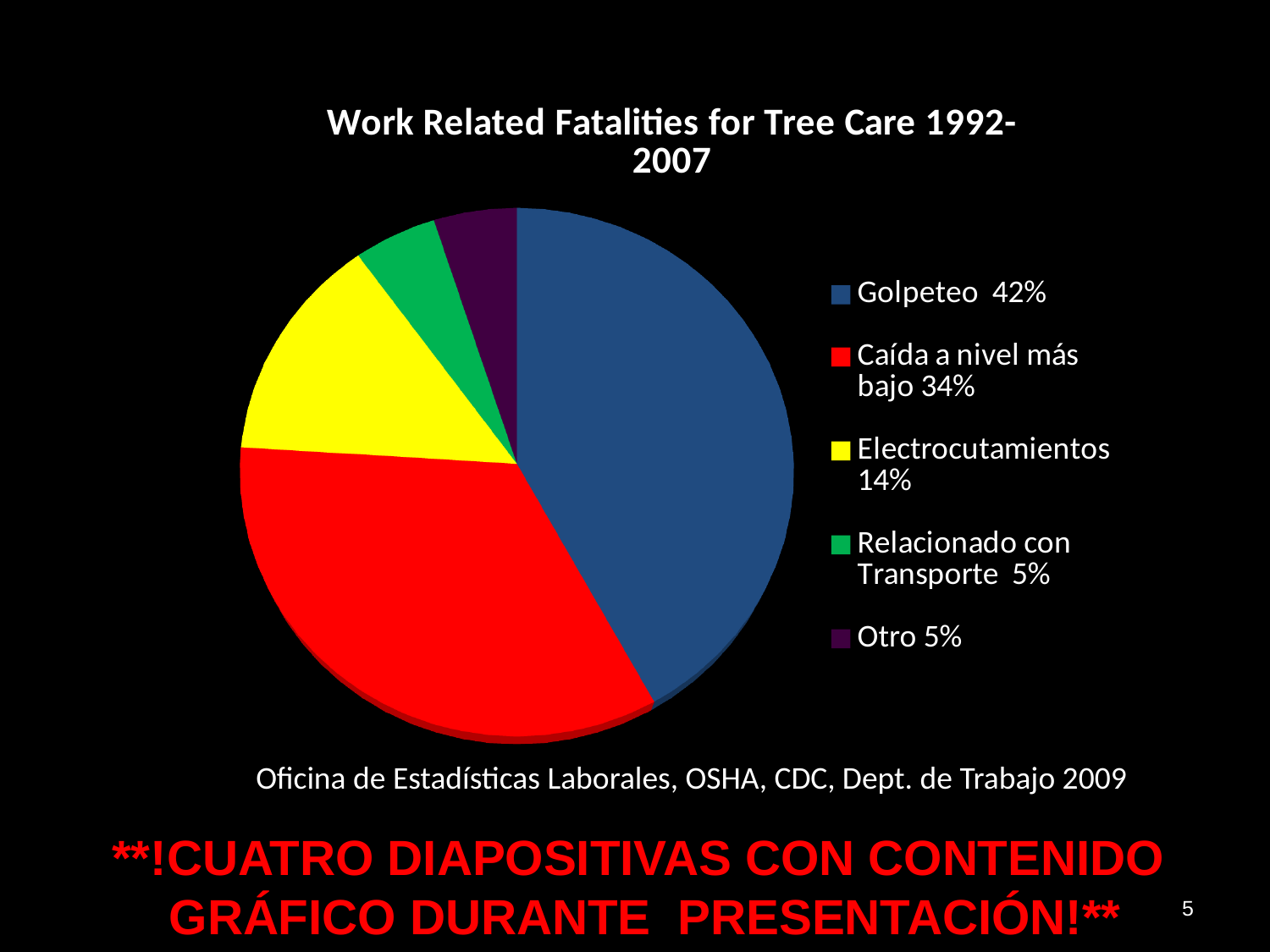
What share of the pie does Electrocutamientos represent? 14% How many categories does the legend list? 5 What is the difference between the Golpeteo share and the Caída a nivel más bajo share? 8% What share of the pie does Golpeteo represent? 42% What kind of chart is shown on the slide? pie chart Which is larger, the share for Electrocutamientos or the share for Otro? Electrocutamientos What colour is the slice for Electrocutamientos? yellow What is the title of the chart? Work Related Fatalities for Tree Care 1992-2007 What share of the pie does Caída a nivel más bajo represent? 34% What is the difference between the Electrocutamientos share and the Relacionado con Transporte share? 9% Which category has the largest slice of the pie? Golpeteo